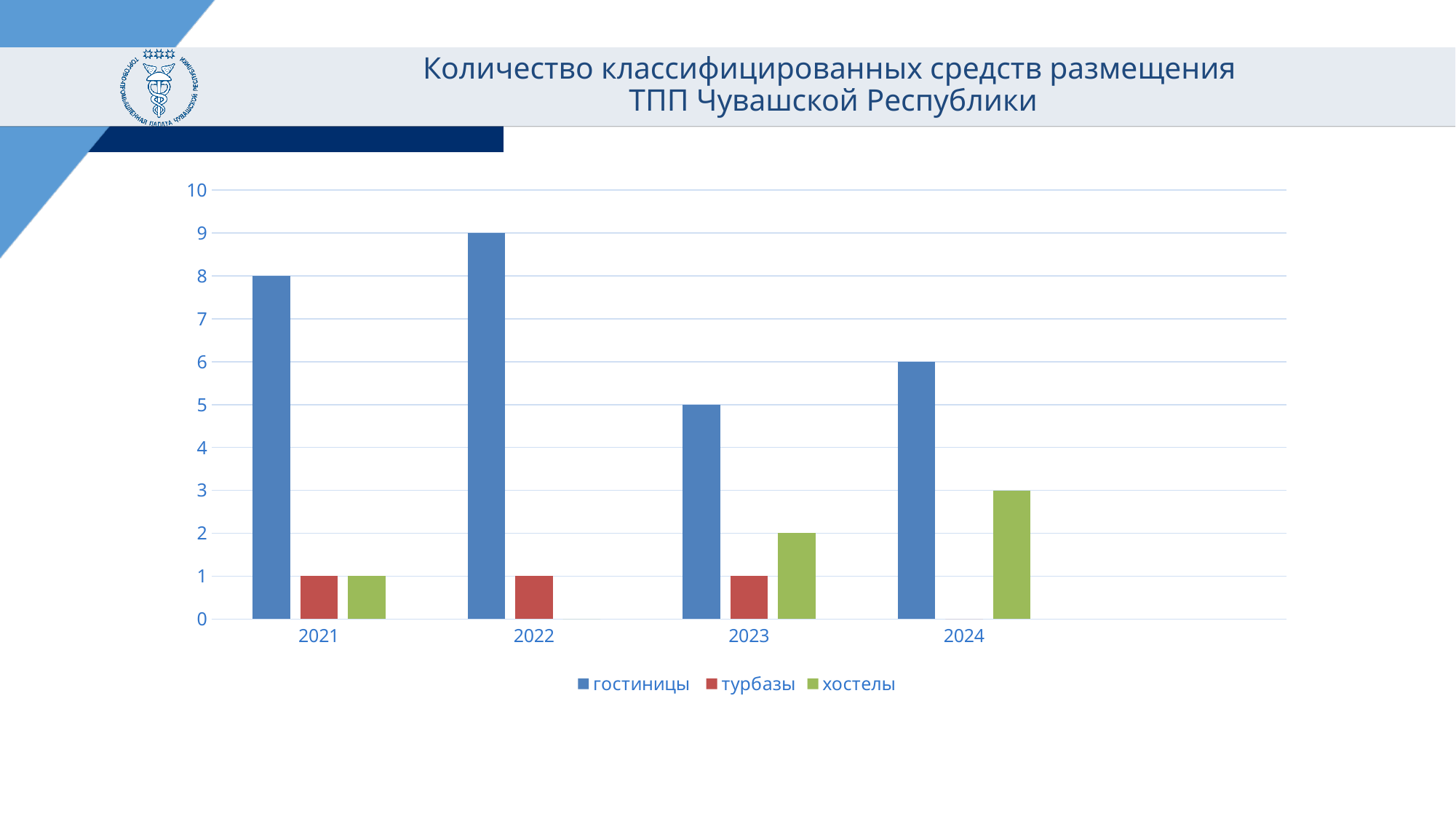
Does the value for хостелы rise or fall from 2023 to 2024? rise What kind of chart is shown on the slide? bar chart In which year is the value for гостиницы lowest? 2023 How many years are shown on the x axis? 4 In which year is the value for гостиницы highest? 2022 What is the value for турбазы in 2023? 1 What is the value for хостелы in 2024? 3 How many series does the legend list? 3 Which is larger: хостелы in 2023 or хостелы in 2024? хостелы in 2024 Is the value for гостиницы in 2021 greater or less than 5? greater What is the difference between the гостиницы values for 2022 and 2023? 4 What is the value for гостиницы in 2022? 9